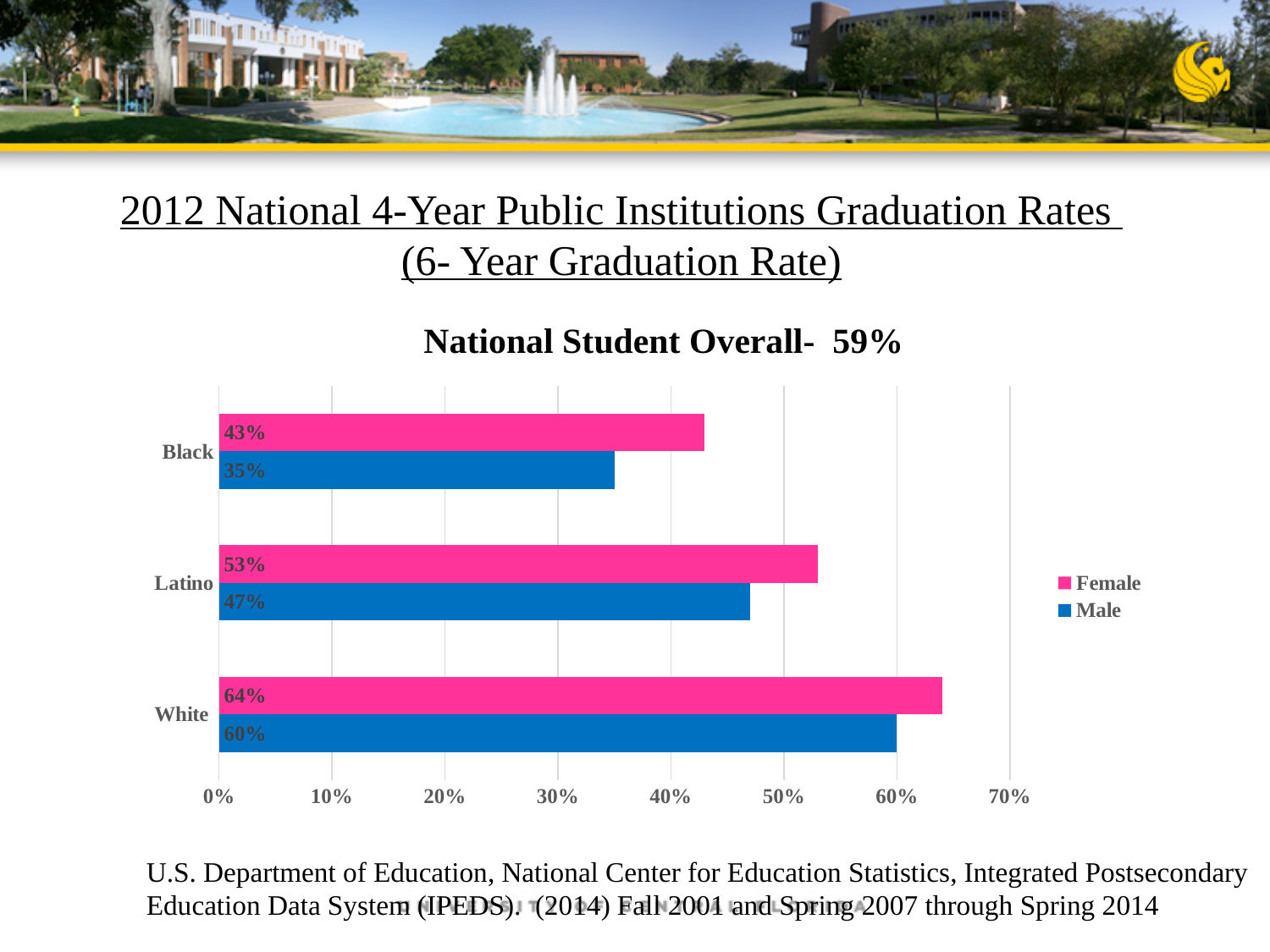
What kind of chart is shown on the slide? Bar chart What is the National Student Overall graduation rate stated above the chart? 59% Which category has the lowest Male graduation rate? Black What is the difference between the Female and Male graduation rates for Black students? 8% How many series does the legend list? 2 What is the Male graduation rate for Latino students? 47% What is the difference between the White and Latino Female graduation rates? 11% Which category has the highest Female graduation rate? White What is the Male graduation rate for White students? 60% How many categories are shown on the chart? 3 Which is larger, the Female rate for Latino students or the Male rate for White students? Male rate for White students What is the Female graduation rate for Black students? 43%